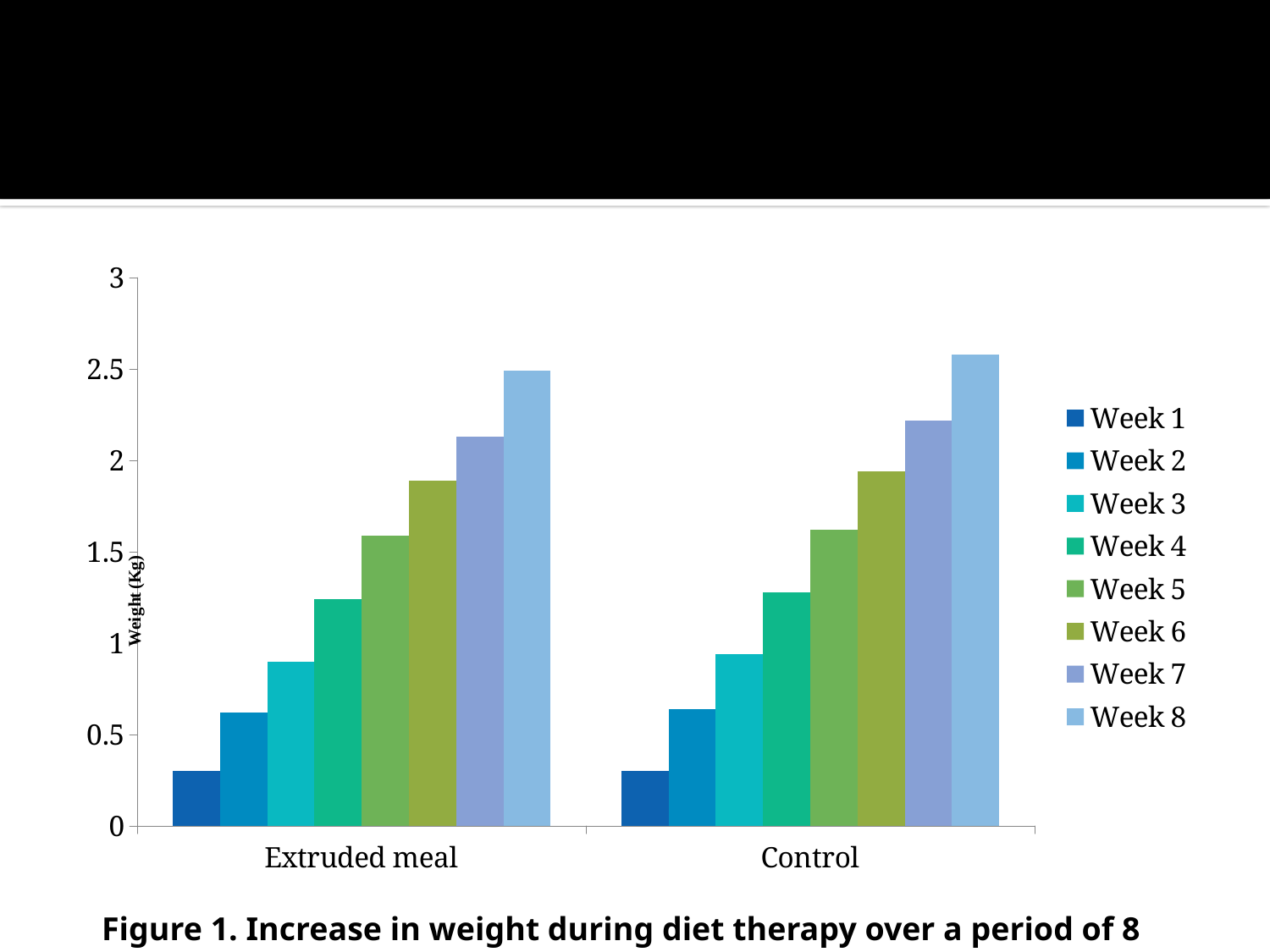
Is the Week 7 value for Control greater or less than 2? greater Which series has the lowest value in the Control group? Week 1 What is the label on the y axis? Weight (Kg) Is the Week 6 value for Extruded meal greater or less than 2? less How many series does the legend list? 8 Do the values within each group rise or fall from Week 1 to Week 8? rise How many categories are shown on the x axis? 2 Which series has the highest value in the Extruded meal group? Week 8 What kind of chart is shown on the slide? bar chart Is the Week 1 value for Control greater or less than 0.5? less Which is larger, the Week 8 value for Extruded meal or the Week 8 value for Control? Control